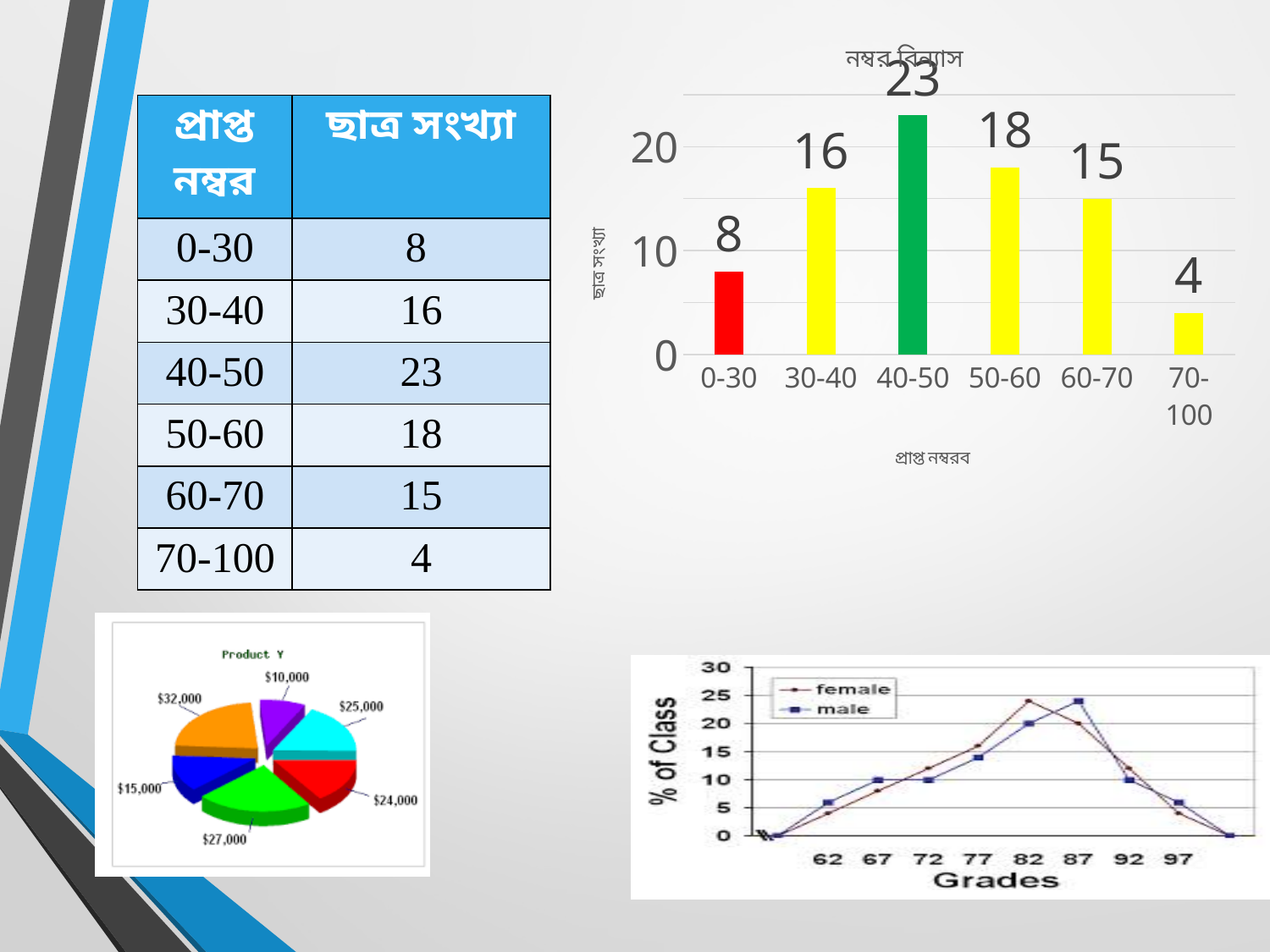
In the bar chart at the top right, what is the difference between the values for 50-60 and 60-70? 3 In the bar chart at the top right, how many students scored in the 40-50 range? 23 In the line chart at the bottom right, is the female value at grade 82 greater or less than 20? greater In the bar chart at the top right, which score range has the lowest number of students? 70-100 How many categories are shown on the x axis of the bar chart at the top right? 6 How many series does the legend of the line chart at the bottom right list? 2 In the bar chart at the top right, what is the value for the 70-100 category? 4 How many slices does the pie chart titled Product Y have? 6 In the bar chart at the top right, which is larger: the value for 30-40 or the value for 0-30? 30-40 In the pie chart titled Product Y, which slice has the largest value? $32,000 What kind of chart is the chart at the top right of the slide? bar chart In the bar chart at the top right, which score range has the highest number of students? 40-50